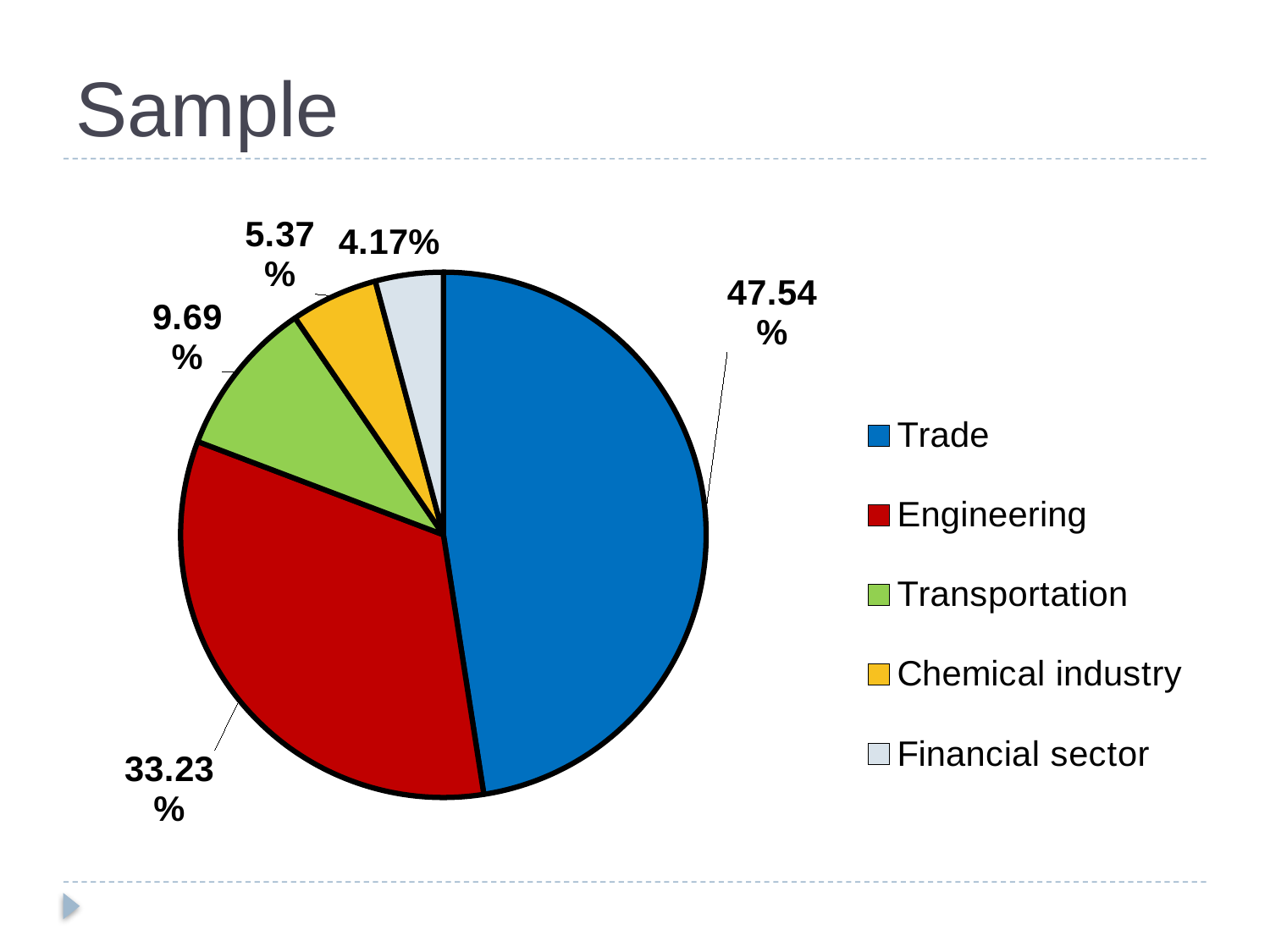
What kind of chart is shown on the slide? pie chart What is the difference in percentage points between Trade and Engineering? 14.31 What share of the pie does Chemical industry have? 5.37% What share of the pie does Transportation have? 9.69% Which is larger, the share for Transportation or the share for Chemical industry? Transportation What share of the pie does Trade have? 47.54% How many categories are shown in the pie chart? 5 What share of the pie does Engineering have? 33.23% What share of the pie does Financial sector have? 4.17% Which category has the largest slice of the pie? Trade Which category has the smallest slice of the pie? Financial sector Which colour represents Engineering in the pie chart? red